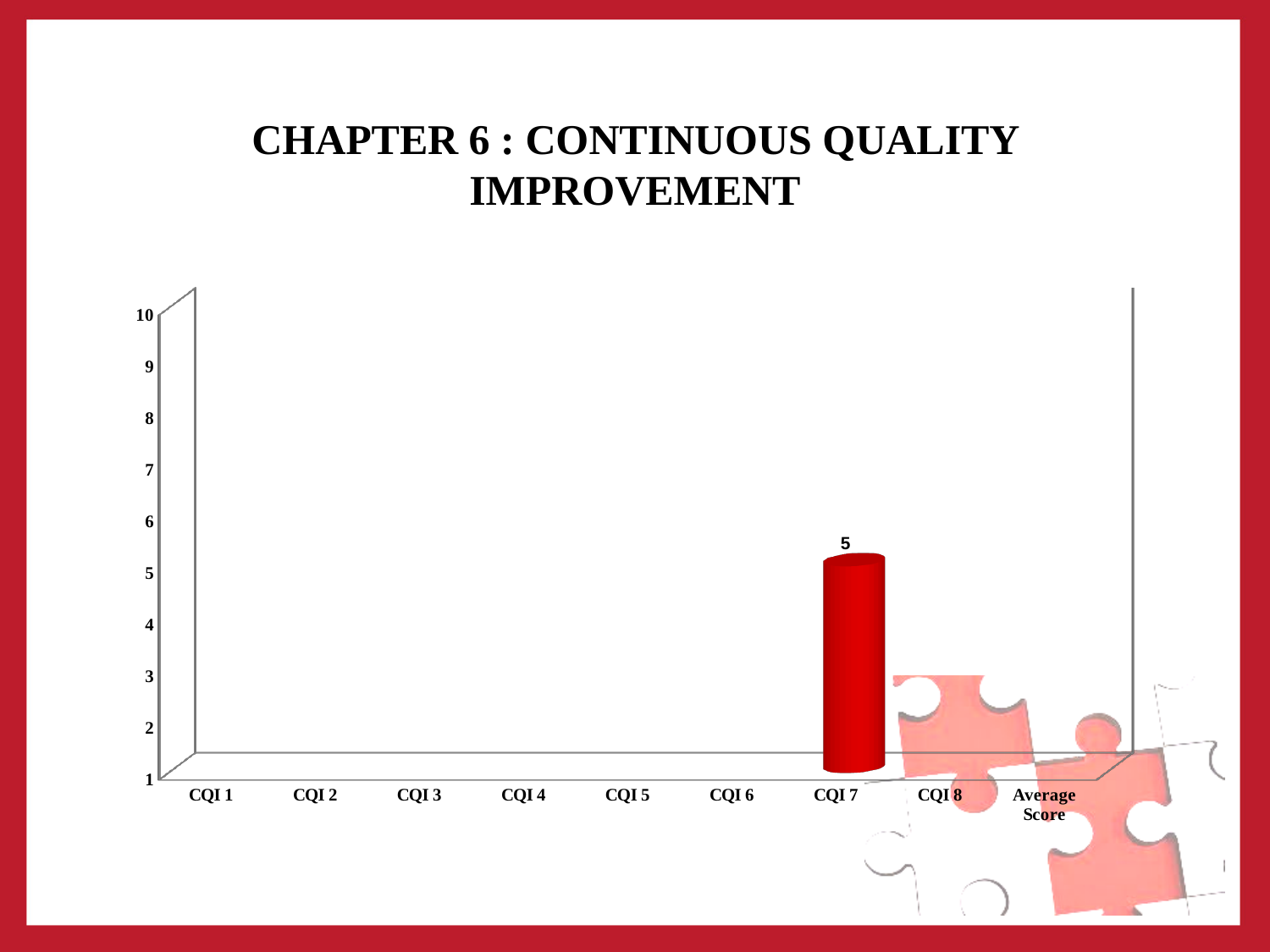
What is the value for CQI 7? 5 What is the highest value shown on the y axis? 10 How many categories are listed along the x axis? 9 Is the value for CQI 7 greater or less than 3? greater How many bars are plotted on the chart? 1 What kind of chart is shown on the slide? bar chart What is the title shown above the chart? CHAPTER 6 : CONTINUOUS QUALITY IMPROVEMENT Which category has the highest value? CQI 7 What colour is the bar for CQI 7? red Is the value for CQI 7 greater or less than 8? less